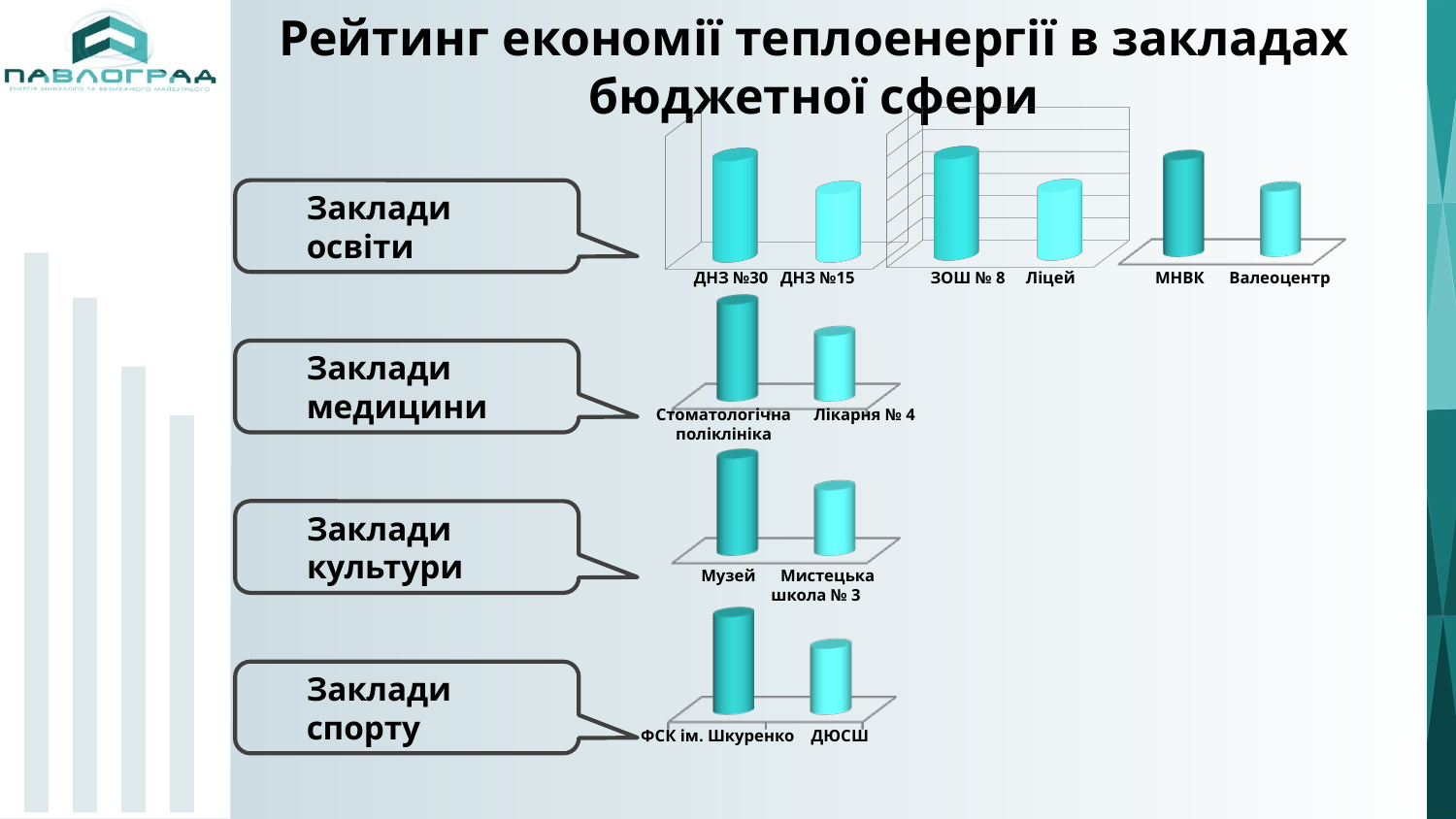
In the "Заклади медицини" chart, which category has the taller bar, Стоматологічна поліклініка or Лікарня № 4? Стоматологічна поліклініка In the middle chart of the "Заклади освіти" row, which category has the lowest bar? Ліцей What is the title of the slide containing these charts? Рейтинг економії теплоенергії в закладах бюджетної сфери What kind of chart is used in the "Заклади медицини" row? bar chart How many categories are shown in the "Заклади спорту" chart? 2 In the "Заклади спорту" chart, which category has the taller bar, ФСК ім. Шкуренко or ДЮСШ? ФСК ім. Шкуренко In the rightmost chart of the "Заклади освіти" row, which category has the highest bar? МНВК In the "Заклади культури" chart, which category has the highest bar? Музей How many categories in total are labelled across the charts in the "Заклади освіти" row? 6 In the leftmost chart of the "Заклади освіти" row, which category has the taller bar, ДНЗ №30 or ДНЗ №15? ДНЗ №30 How many separate chart rows (sector groups) are shown on the slide? 4 In the "Заклади культури" chart, which category has the lowest bar? Мистецька школа № 3